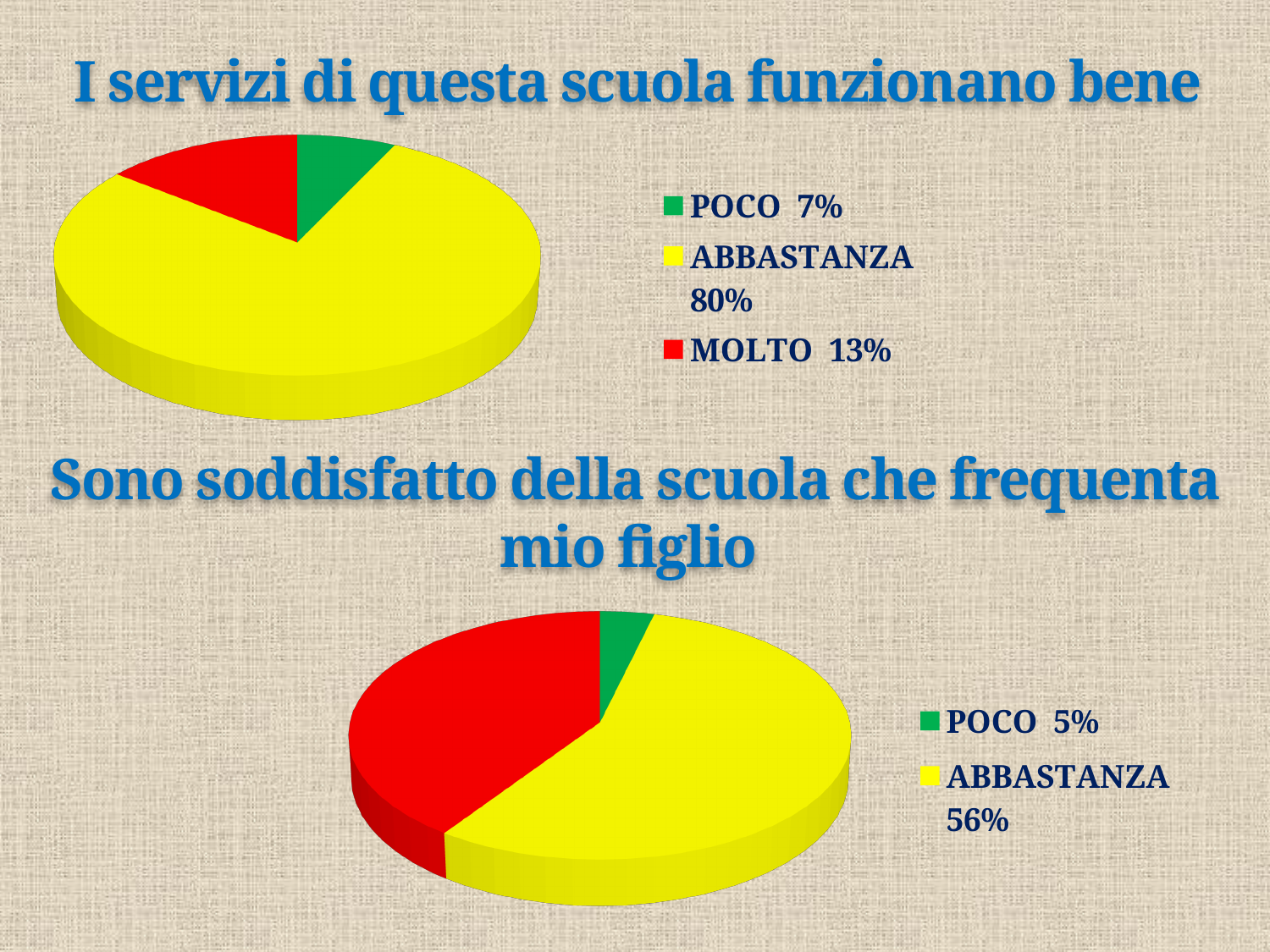
In the chart titled "I servizi di questa scuola funzionano bene", which category has the smallest share? POCO In the chart titled "Sono soddisfatto della scuola che frequenta mio figlio", what colour is the ABBASTANZA slice? Yellow In the chart titled "Sono soddisfatto della scuola che frequenta mio figlio", which is larger, POCO or ABBASTANZA? ABBASTANZA In the chart titled "I servizi di questa scuola funzionano bene", what percentage is shown for ABBASTANZA? 80% In the chart titled "I servizi di questa scuola funzionano bene", how many categories does the legend list? 3 In the chart titled "I servizi di questa scuola funzionano bene", what percentage is shown for POCO? 7% In the chart titled "Sono soddisfatto della scuola che frequenta mio figlio", what percentage is shown for POCO? 5% In the chart titled "I servizi di questa scuola funzionano bene", what is the difference between the MOLTO and POCO percentages? 6% What type of chart is used for "Sono soddisfatto della scuola che frequenta mio figlio"? Pie chart In the chart titled "I servizi di questa scuola funzionano bene", which category has the largest share? ABBASTANZA In the chart titled "Sono soddisfatto della scuola che frequenta mio figlio", what percentage is shown for ABBASTANZA? 56% In the chart titled "I servizi di questa scuola funzionano bene", what percentage is shown for MOLTO? 13%